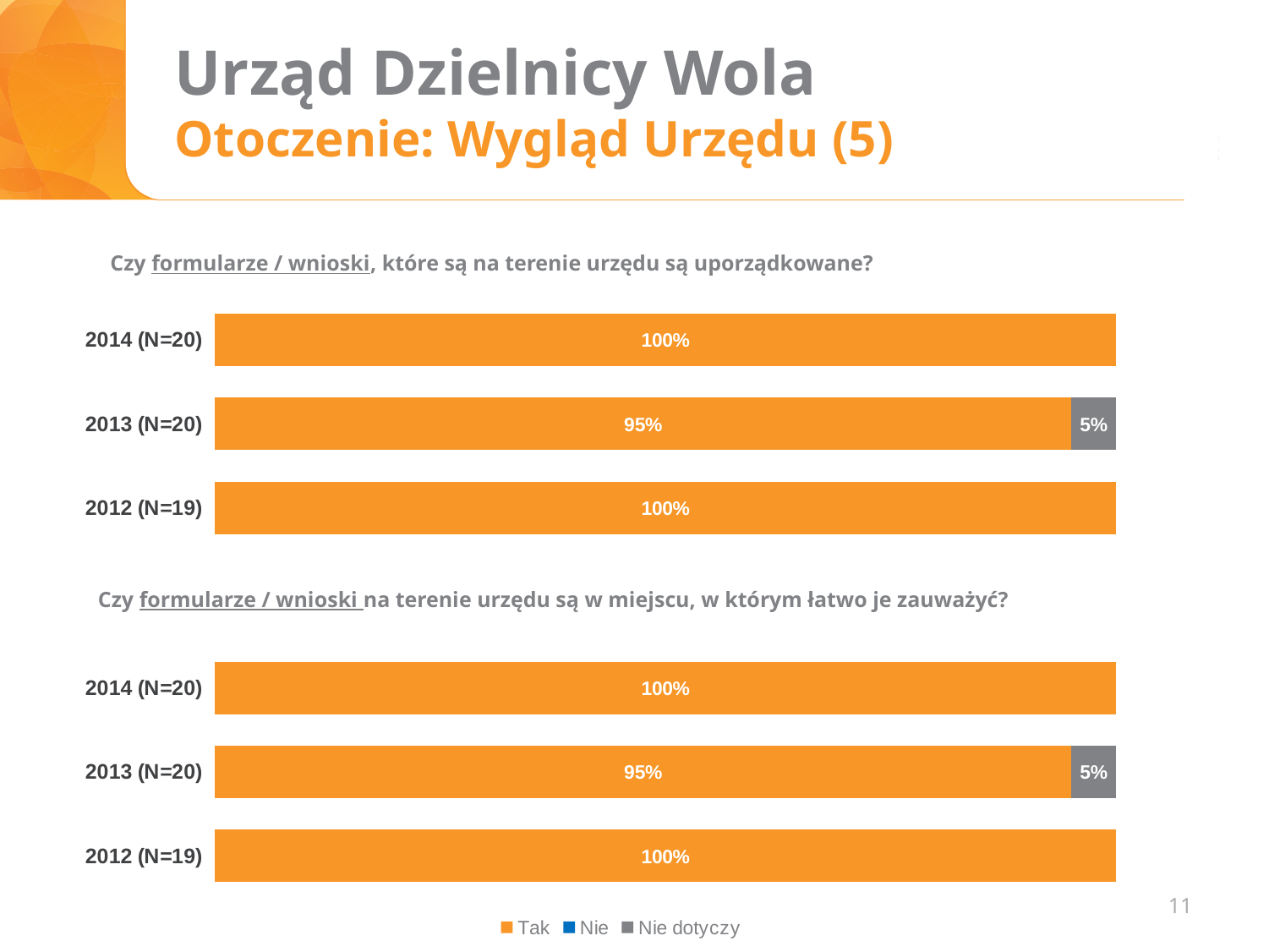
In the top chart ("Czy formularze / wnioski, które są na terenie urzędu są uporządkowane?"), what is the value for Tak in 2013 (N=20)? 95% In the top chart ("Czy formularze / wnioski, które są na terenie urzędu są uporządkowane?"), which year has the lowest Tak value? 2013 (N=20) In the bottom chart ("Czy formularze / wnioski na terenie urzędu są w miejscu, w którym łatwo je zauważyć?"), what is the difference between the Tak value in 2014 (N=20) and in 2013 (N=20)? 5% How many series does the legend at the bottom of the slide list? 3 How many year categories does the bottom chart ("Czy formularze / wnioski na terenie urzędu są w miejscu, w którym łatwo je zauważyć?") show? 3 In the top chart ("Czy formularze / wnioski, które są na terenie urzędu są uporządkowane?"), which is larger: the Tak value in 2012 (N=19) or in 2013 (N=20)? 2012 (N=19) What type of chart is the top chart ("Czy formularze / wnioski, które są na terenie urzędu są uporządkowane?")? Stacked horizontal bar chart In the top chart ("Czy formularze / wnioski, które są na terenie urzędu są uporządkowane?"), what is the value for Tak in 2014 (N=20)? 100% In the bottom chart ("Czy formularze / wnioski na terenie urzędu są w miejscu, w którym łatwo je zauważyć?"), what is the total of the 2013 (N=20) bar (95% plus 5%)? 100% In the top chart ("Czy formularze / wnioski, które są na terenie urzędu są uporządkowane?"), what is the value of the grey Nie dotyczy segment in 2013 (N=20)? 5% In the bottom chart ("Czy formularze / wnioski na terenie urzędu są w miejscu, w którym łatwo je zauważyć?"), what is the value for Tak in 2013 (N=20)? 95% In the bottom chart ("Czy formularze / wnioski na terenie urzędu są w miejscu, w którym łatwo je zauważyć?"), what is the value for Tak in 2012 (N=19)? 100%